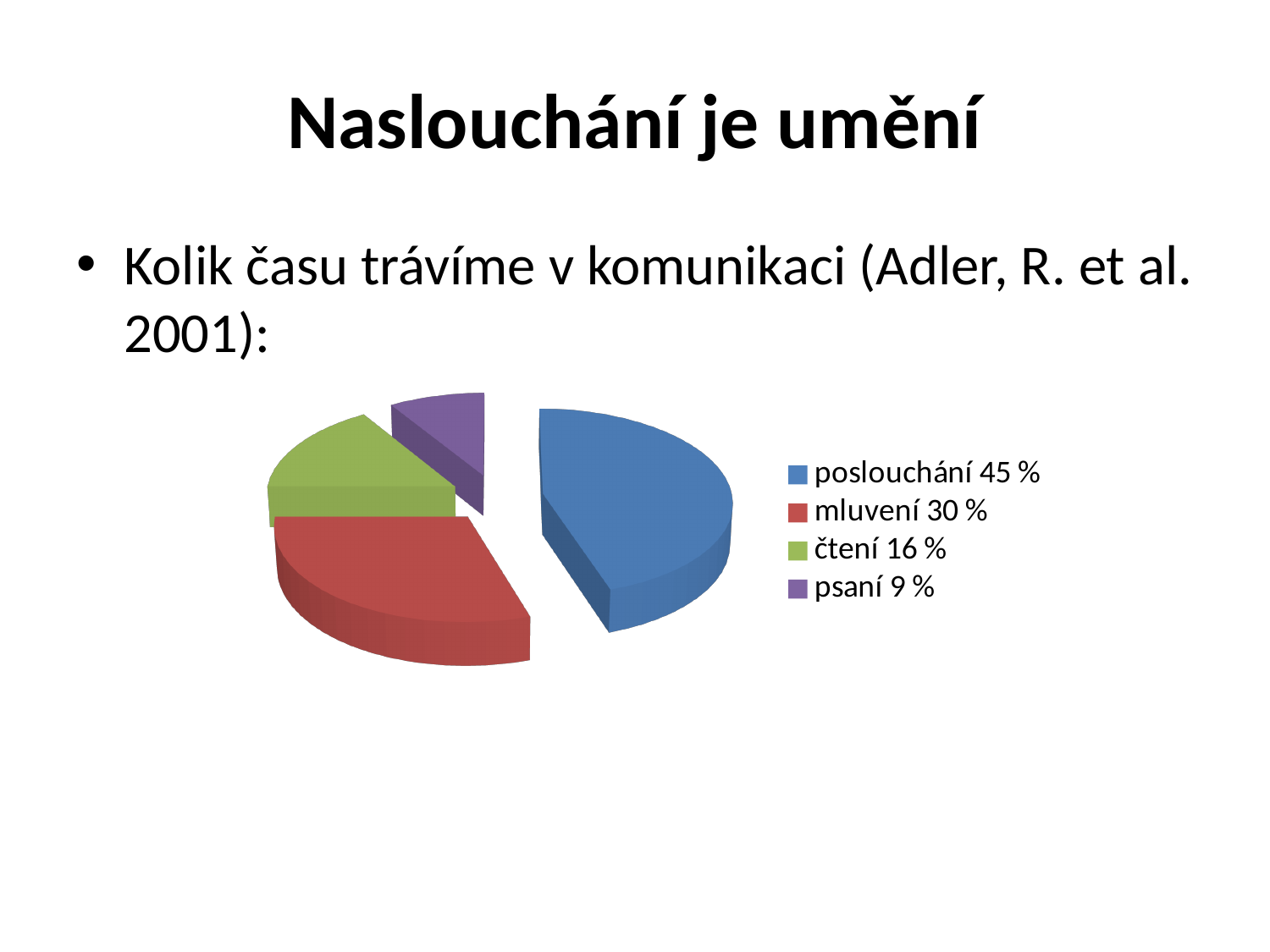
What kind of chart is shown on the slide? pie chart What share of the pie does psaní have? 9 % What colour is the slice for mluvení? red Which category has the smallest slice of the pie? psaní How many entries does the legend list? 4 Which category has the largest slice of the pie? poslouchání Which is larger, the share of čtení or the share of psaní? čtení What share of the pie does čtení have? 16 % What is the difference between the shares of poslouchání and mluvení? 15 % How many slices does the pie chart have? 4 What share of the pie does poslouchání have? 45 %